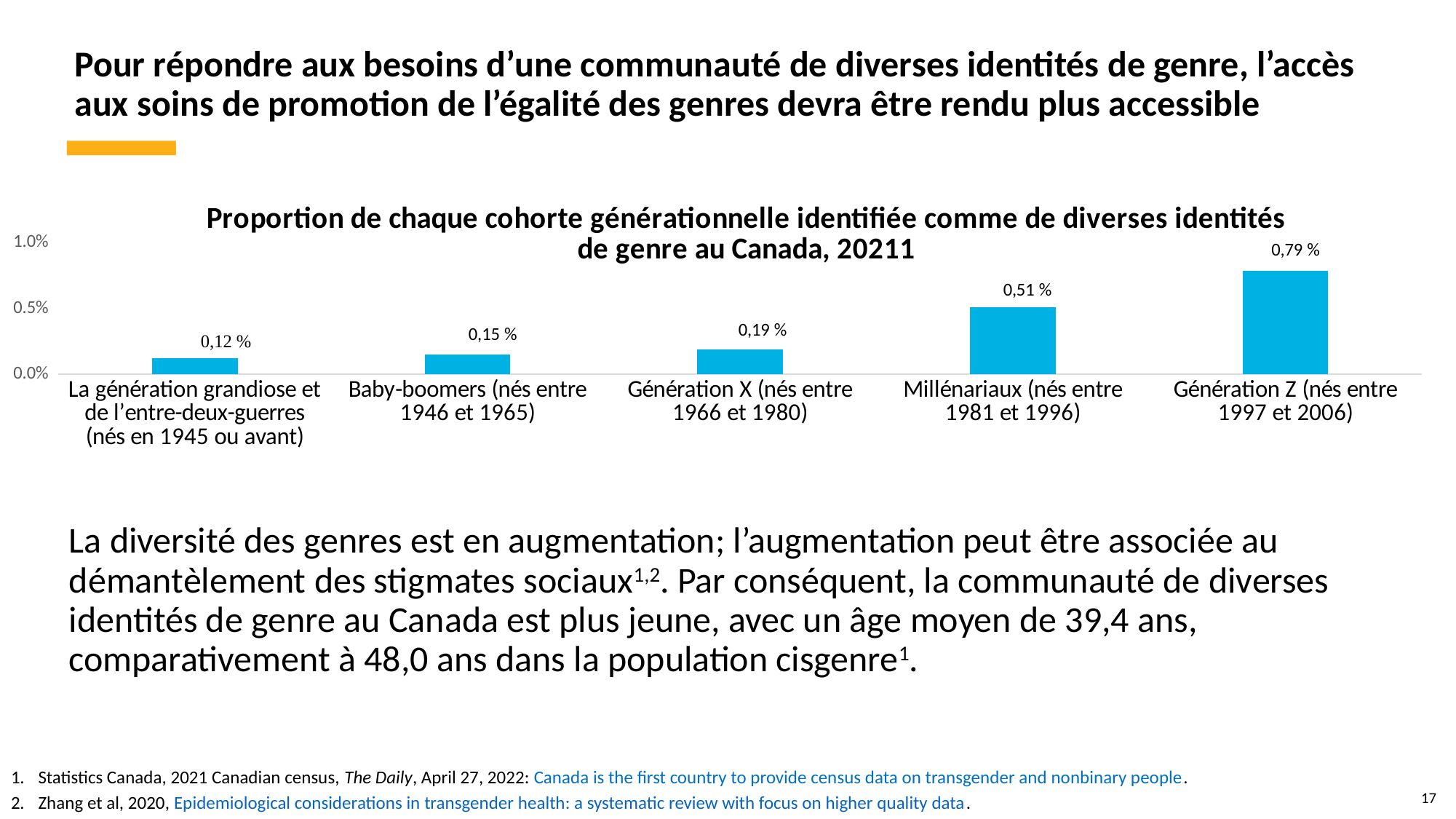
Which generational cohort has the highest proportion? Génération Z (nés entre 1997 et 2006) How many generational cohorts are shown in the chart? 5 What is the difference between the values for Génération Z and Millénariaux? 0,28 % What is the difference between the values for Génération X and Baby-boomers? 0,04 % Do the values rise or fall from the oldest cohort on the left to the youngest cohort on the right? Rise What is the value for Génération Z (nés entre 1997 et 2006)? 0,79 % What kind of chart is shown on the slide? Bar chart Which is larger, the value for Millénariaux or the value for Génération X? Millénariaux Which generational cohort has the lowest proportion? La génération grandiose et de l'entre-deux-guerres (nés en 1945 ou avant) What is the value for Baby-boomers (nés entre 1946 et 1965)? 0,15 % Is the value for Génération Z greater or less than 0.5%? greater What is the value for Millénariaux (nés entre 1981 et 1996)? 0,51 %